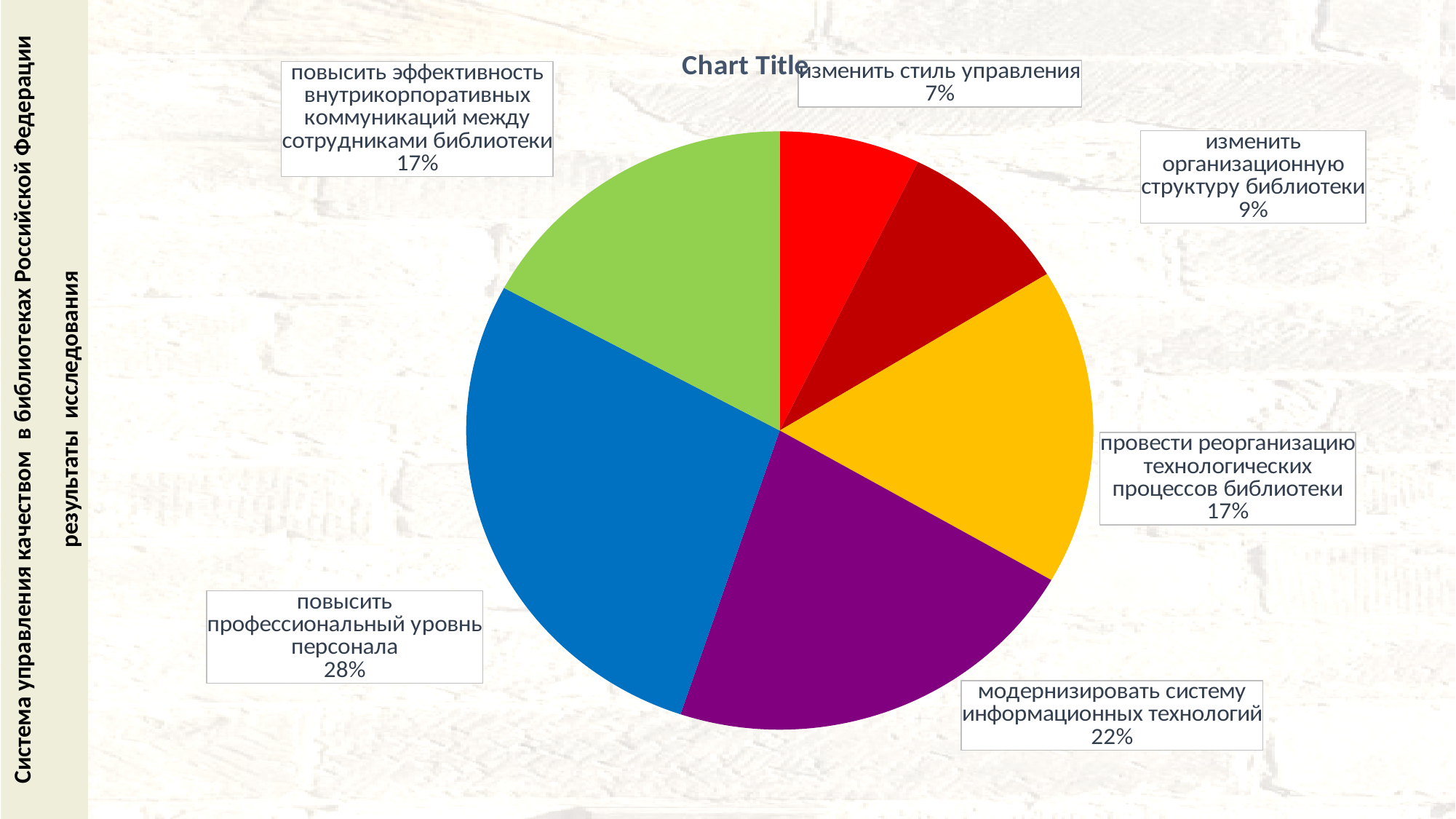
Which category has the largest share of the pie? повысить профессиональный уровень персонала What share of the pie is labelled "изменить организационную структуру библиотеки"? 9% What share of the pie is labelled "повысить профессиональный уровень персонала"? 28% What share of the pie is labelled "модернизировать систему информационных технологий"? 22% How many slices does the pie chart have? 6 What is the difference in percentage points between "повысить профессиональный уровень персонала" and "модернизировать систему информационных технологий"? 6 Which is larger: the share for "изменить организационную структуру библиотеки" or the share for "провести реорганизацию технологических процессов библиотеки"? провести реорганизацию технологических процессов библиотеки Which category has the smallest share of the pie? изменить стиль управления What is the title of the chart? Chart Title What colour is the slice for "повысить профессиональный уровень персонала"? blue What kind of chart is shown on the slide? pie chart